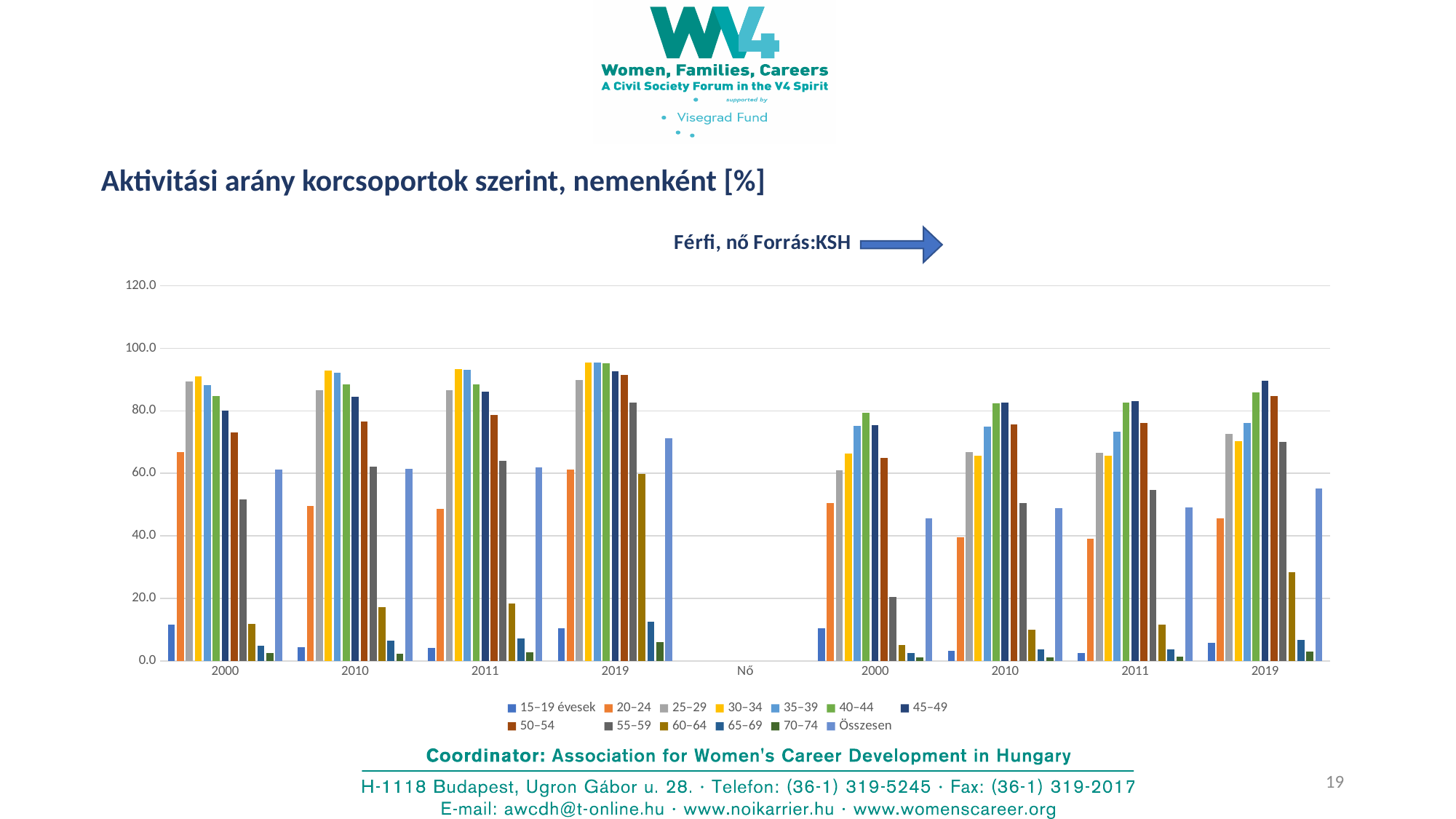
Is the value for Összesen in the women's 2019 group greater or less than 40? greater What kind of chart is shown on the slide? bar chart Is the value for 60–64 in the women's 2019 group greater or less than 20? greater Which source is cited for the chart data? KSH Which age group has the lowest value in the men's 2000 group? 70–74 How many series does the legend list? 13 Is the value for Összesen in the men's 2000 group greater or less than 40? greater Does the Összesen value for women rise or fall from 2000 to 2019? rise Which is larger: the 20–24 value in the men's 2000 group or the 20–24 value in the women's 2000 group? men's 2000 group What is the title of the chart? Aktivitási arány korcsoportok szerint, nemenként [%] Which is larger: the 30–34 value in the men's 2019 group or the 30–34 value in the women's 2019 group? men's 2019 group